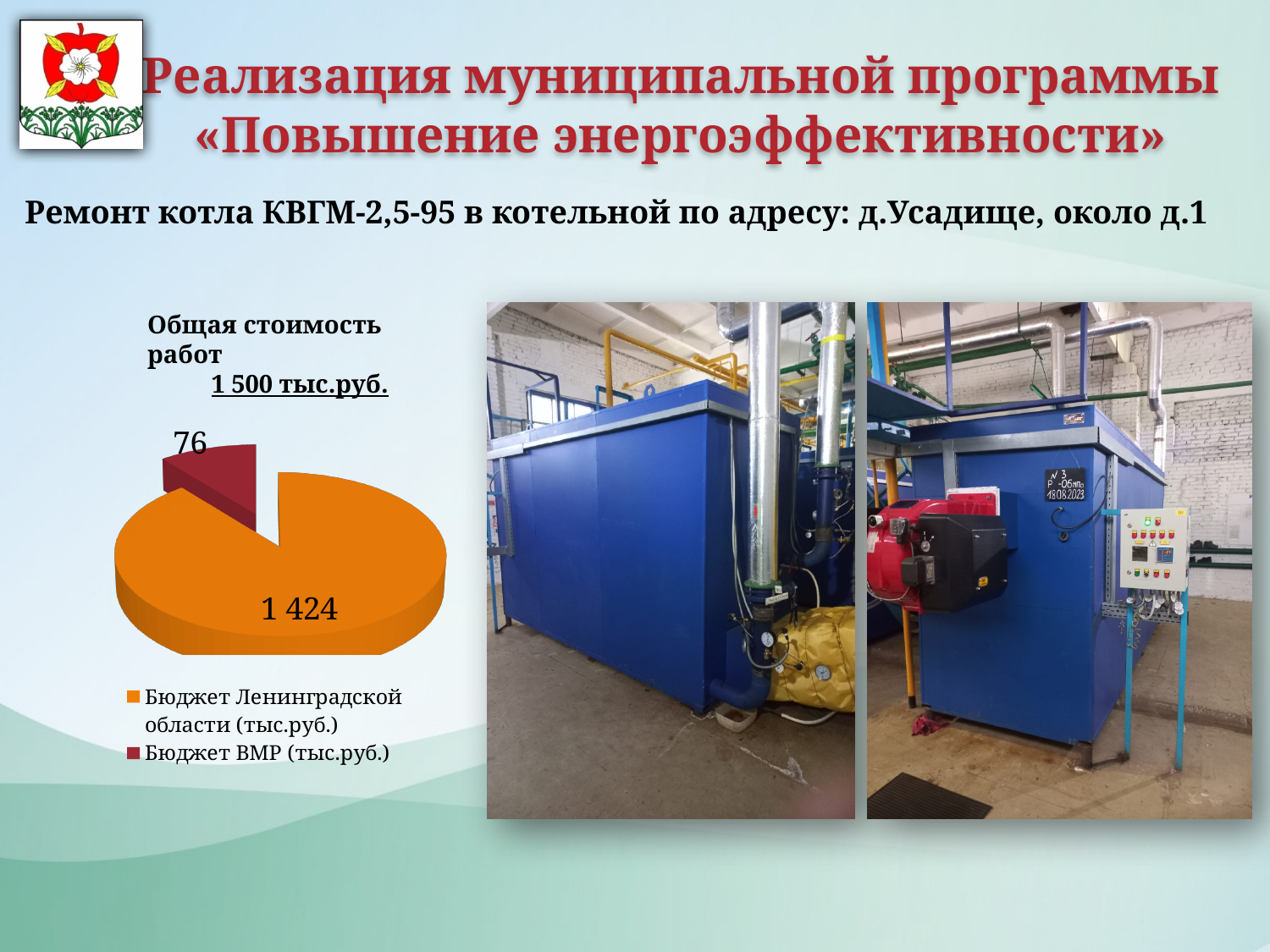
What total cost of works is stated above the pie chart? 1 500 тыс.руб. Which budget source has the largest slice in the pie chart? Бюджет Ленинградской области (тыс.руб.) How many entries does the legend of the pie chart list? 2 What is the value for Бюджет ВМР (тыс.руб.) in the pie chart? 76 What kind of chart is shown on the slide? pie chart What is the difference between the Бюджет Ленинградской области value and the Бюджет ВМР value in the pie chart? 1 348 Which is larger in the pie chart: Бюджет Ленинградской области or Бюджет ВМР? Бюджет Ленинградской области Which budget source has the smallest slice in the pie chart? Бюджет ВМР (тыс.руб.) What is the total of the two values shown in the pie chart? 1 500 How many slices does the pie chart have? 2 What colour is the slice for Бюджет ВМР (тыс.руб.) in the pie chart? dark red What is the value for Бюджет Ленинградской области (тыс.руб.) in the pie chart? 1 424